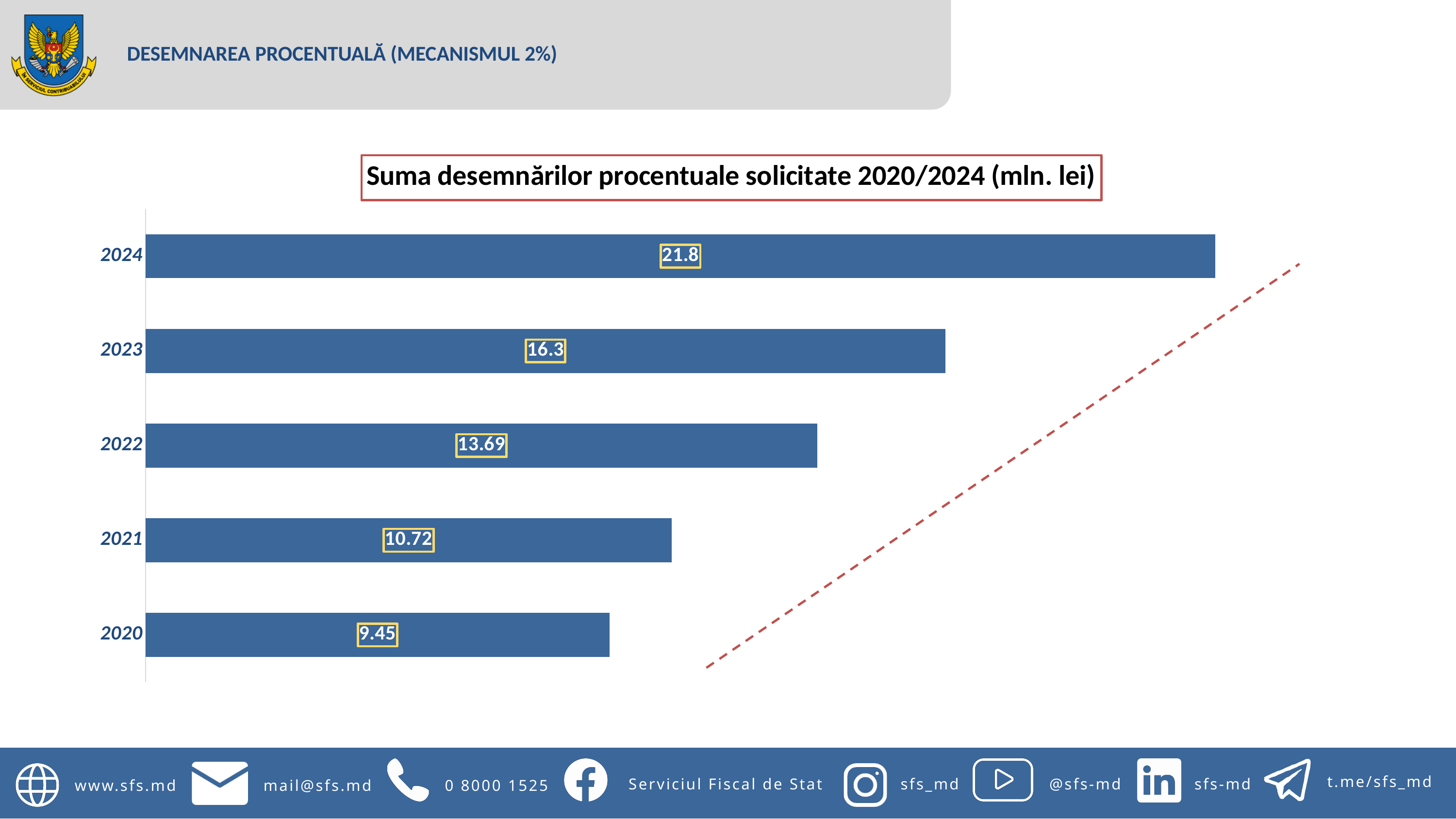
What is the difference between the values for 2021 and 2020? 1.27 What is the value for 2020? 9.45 How many years are shown in the chart? 5 What is the value for 2022? 13.69 Which year has the highest value? 2024 What kind of chart is shown on the slide? bar chart Which is larger, the value for 2022 or the value for 2021? 2022 Which year has the lowest value? 2020 What is the difference between the values for 2024 and 2023? 5.5 What is the title of the chart? Suma desemnărilor procentuale solicitate 2020/2024 (mln. lei) Do the values rise or fall from 2020 to 2024? rise What is the value for 2024? 21.8